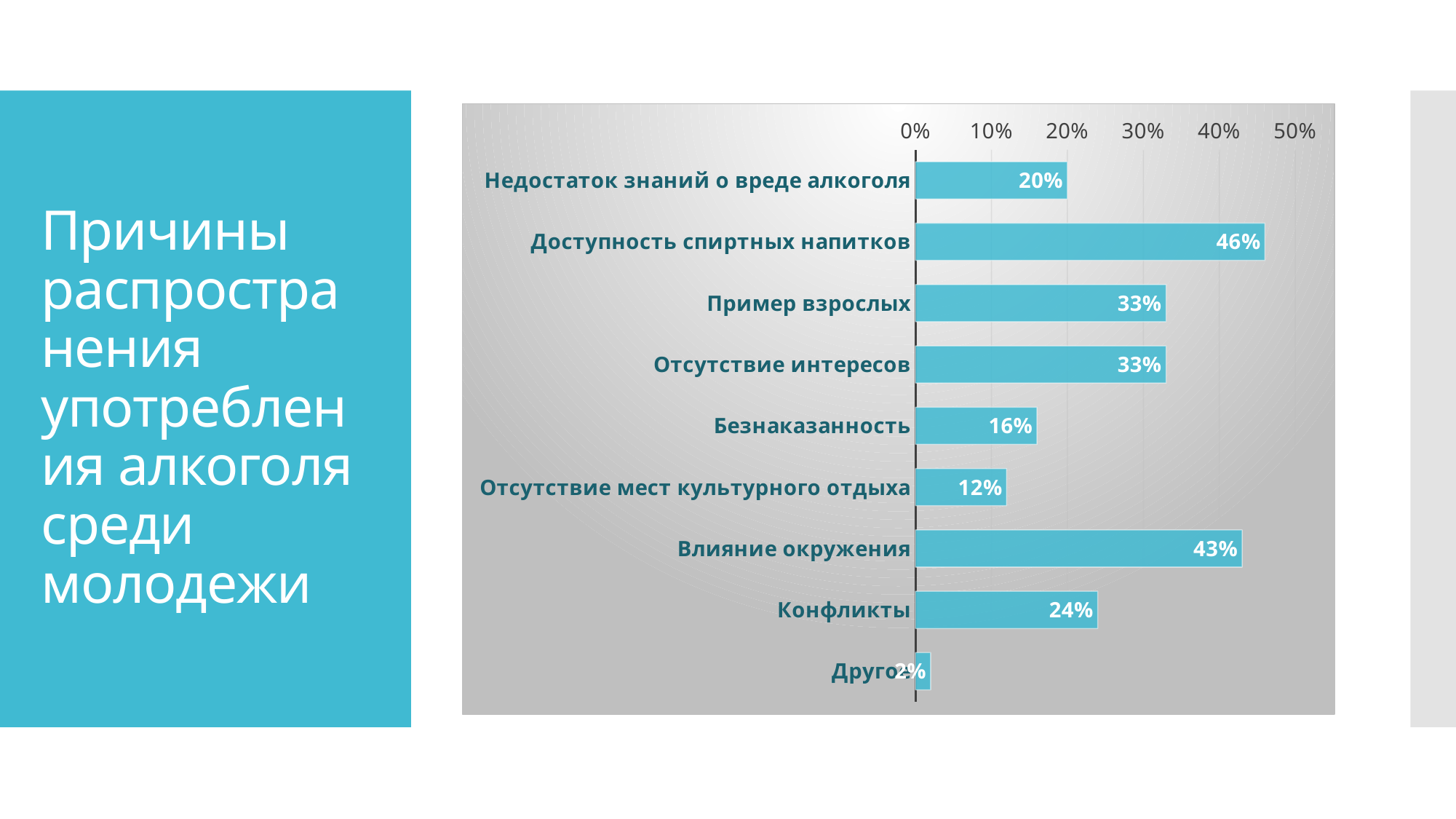
What is the value for Безнаказанность? 16% What type of chart is shown on the slide? bar chart Is the value for Пример взрослых greater or less than 30%? greater Which category has the highest value? Доступность спиртных напитков What is the difference between the values for Доступность спиртных напитков and Влияние окружения? 3% Which category has the lowest value? Другое Which is larger, the value for Недостаток знаний о вреде алкоголя or the value for Конфликты? Конфликты What is the value for Отсутствие мест культурного отдыха? 12% What is the value for Доступность спиртных напитков? 46% How many categories are shown in the chart? 9 What is the value for Конфликты? 24% What is the value for Влияние окружения? 43%